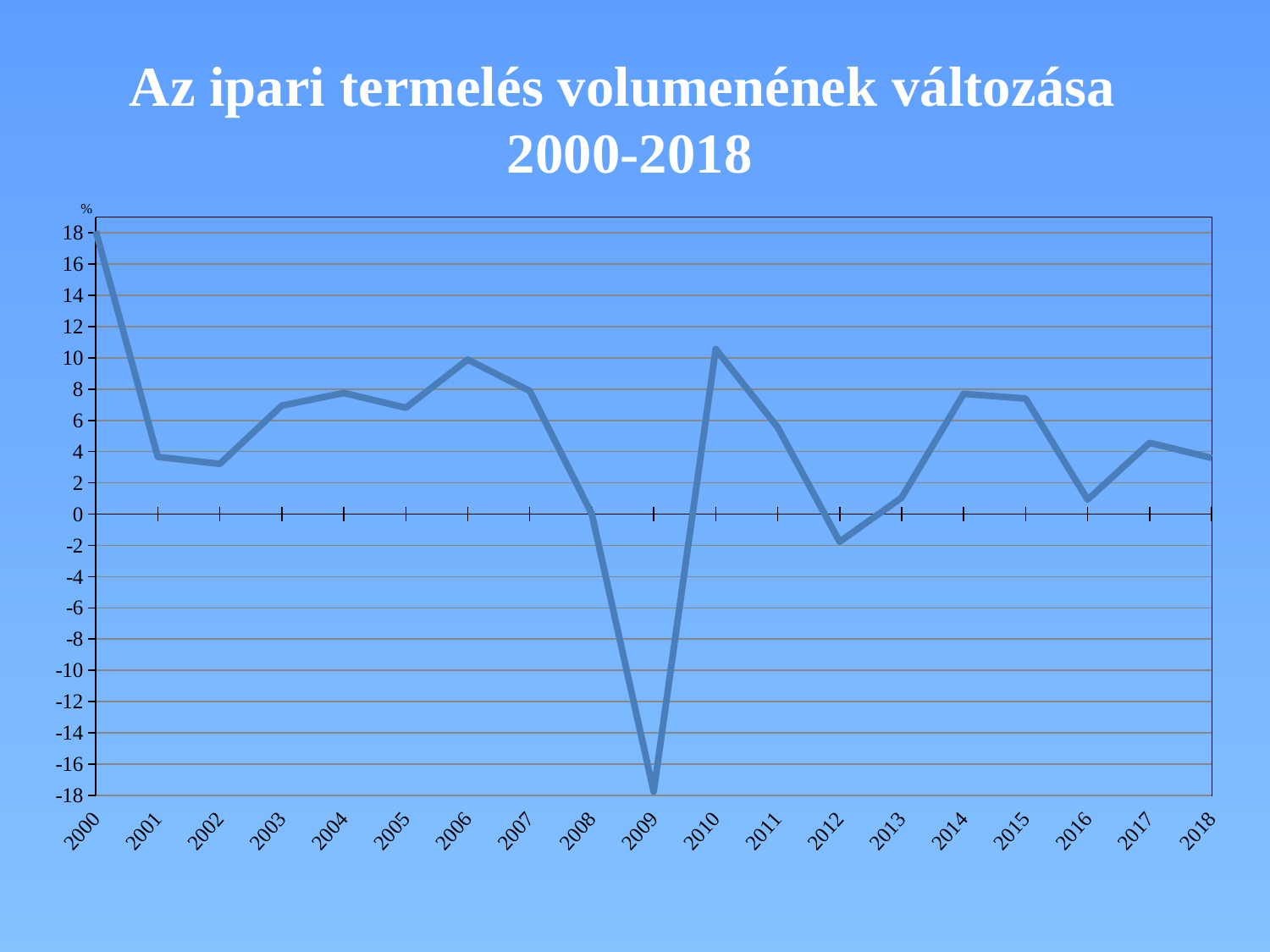
Which year has the larger value, 2006 or 2007? 2006 What kind of chart is shown on the slide? line chart What unit is shown at the top of the vertical axis? % How many years are plotted along the x axis? 19 Which year has the highest value? 2000 Does the value rise or fall from 2009 to 2010? rise Is the value for 2000 greater or less than 14? greater Is the value for 2009 greater or less than -10? less Which year has the larger value, 2013 or 2014? 2014 Is the value for 2016 greater or less than 2? less Which year has the lowest value? 2009